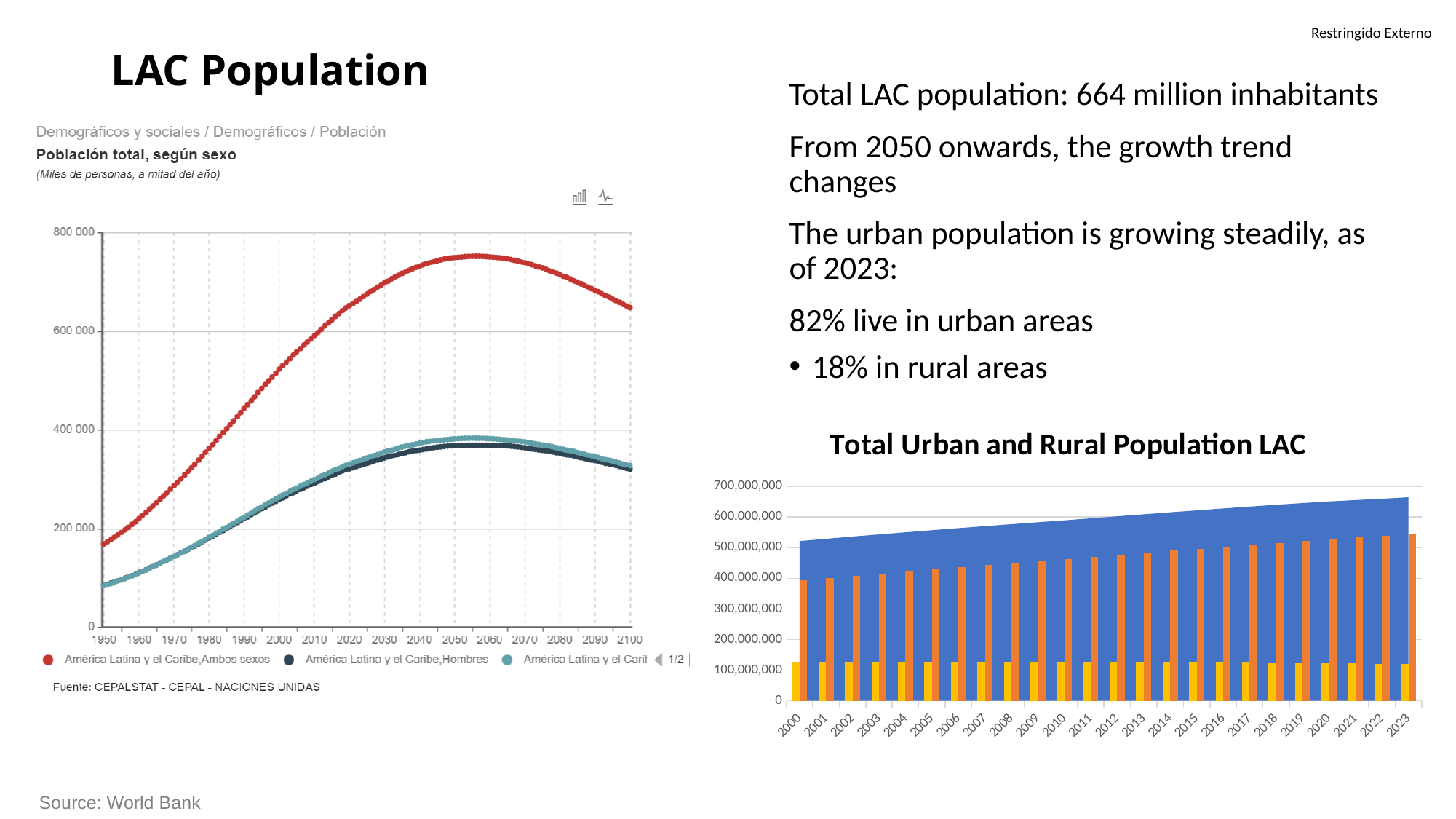
In the right chart 'Total Urban and Rural Population LAC', is the yellow bar for 2023 greater or less than 200,000,000? less In the right chart 'Total Urban and Rural Population LAC', how many years are shown on the x axis? 24 What kind of chart is the left chart titled 'Población total, según sexo'? line chart In the right chart 'Total Urban and Rural Population LAC', is the orange bar for 2023 greater or less than 500,000,000? greater In the left chart 'Población total, según sexo', does the red 'Ambos sexos' line rise or fall between 2070 and 2100? fall In the left chart 'Población total, según sexo', is the value of the red 'Ambos sexos' line in 2050 greater or less than 600 000? greater In the left chart 'Población total, según sexo', does the red 'Ambos sexos' line rise or fall between 1950 and 2040? rise In the left chart 'Población total, según sexo', which series has the highest values across the whole period? América Latina y el Caribe, Ambos sexos In the left chart 'Población total, según sexo', what is the first year shown on the x axis? 1950